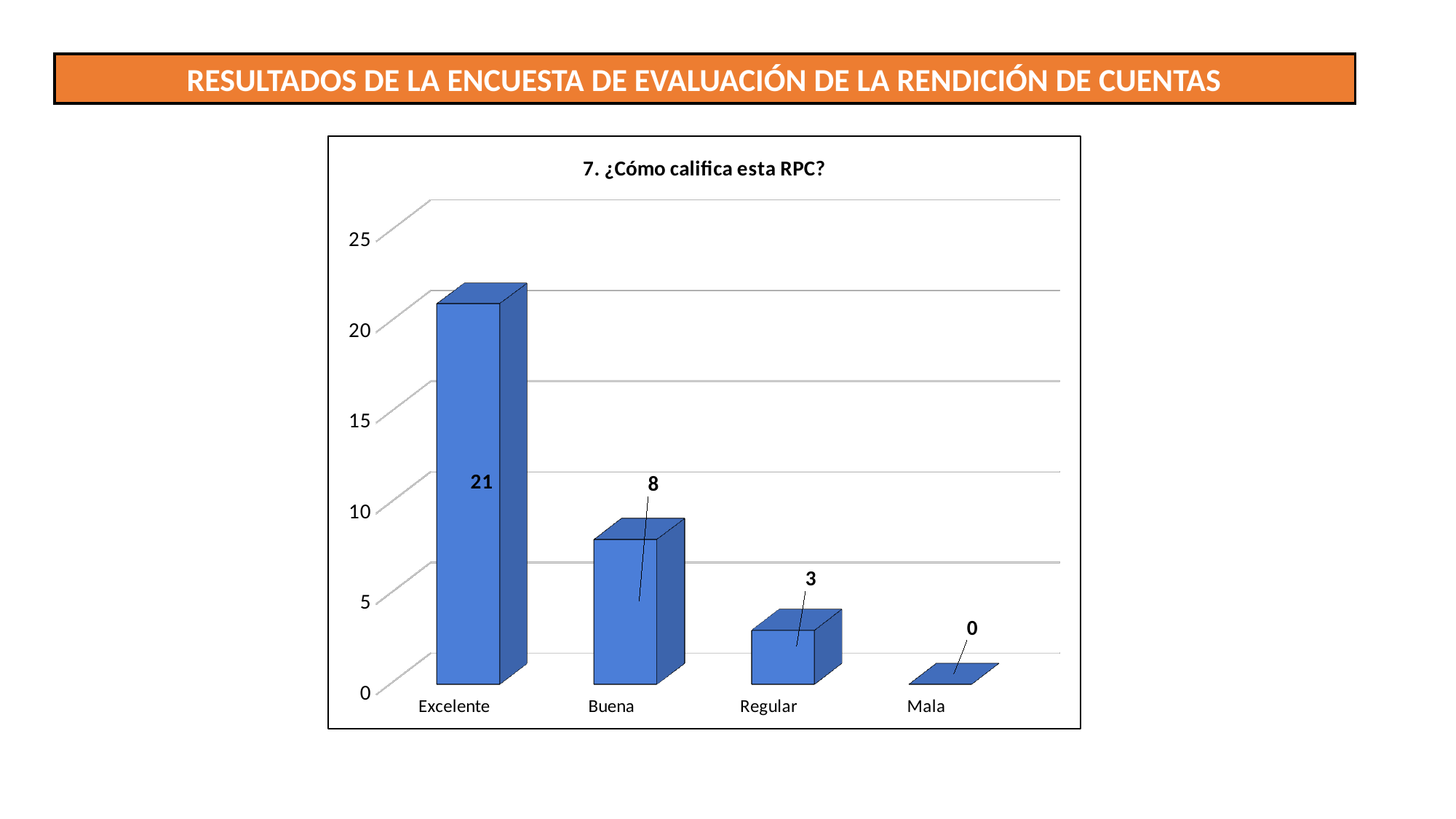
What is the title of the chart? 7. ¿Cómo califica esta RPC? What is the difference between the values for Excelente and Buena? 13 How many categories are shown on the x axis? 4 What is the value for Excelente? 21 Which category has the highest value? Excelente What is the value for Regular? 3 Which is larger, the value for Buena or the value for Regular? Buena What kind of chart is shown? bar chart What is the value for Buena? 8 Is the value for Excelente greater or less than 20? greater Which category has the lowest value? Mala What is the value for Mala? 0